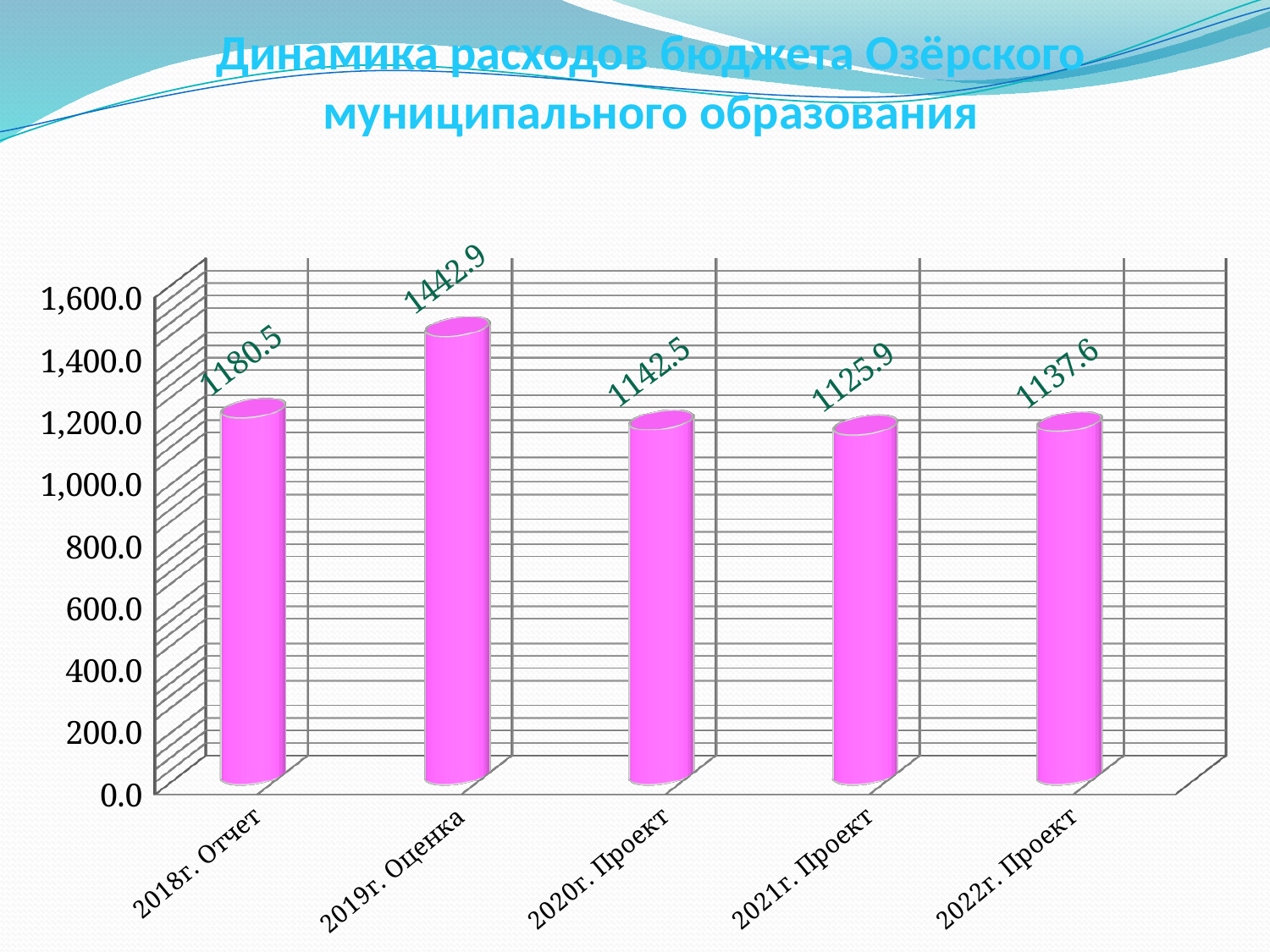
Which category has the lowest value? 2021г. Проект What is the difference between the values for 2020г. Проект and 2022г. Проект? 4.9 What is the title of the chart on the slide? Динамика расходов бюджета Озёрского муниципального образования Which is larger, the value for 2018г. Отчет or the value for 2020г. Проект? 2018г. Отчет What is the value for 2021г. Проект? 1125.9 What is the difference between the values for 2019г. Оценка and 2018г. Отчет? 262.4 Which category has the highest value? 2019г. Оценка How many categories are shown on the x axis? 5 What is the value for 2018г. Отчет? 1180.5 Is the value for 2019г. Оценка greater or less than 1,400.0? greater What is the value for 2019г. Оценка? 1442.9 What kind of chart is shown on the slide? bar chart